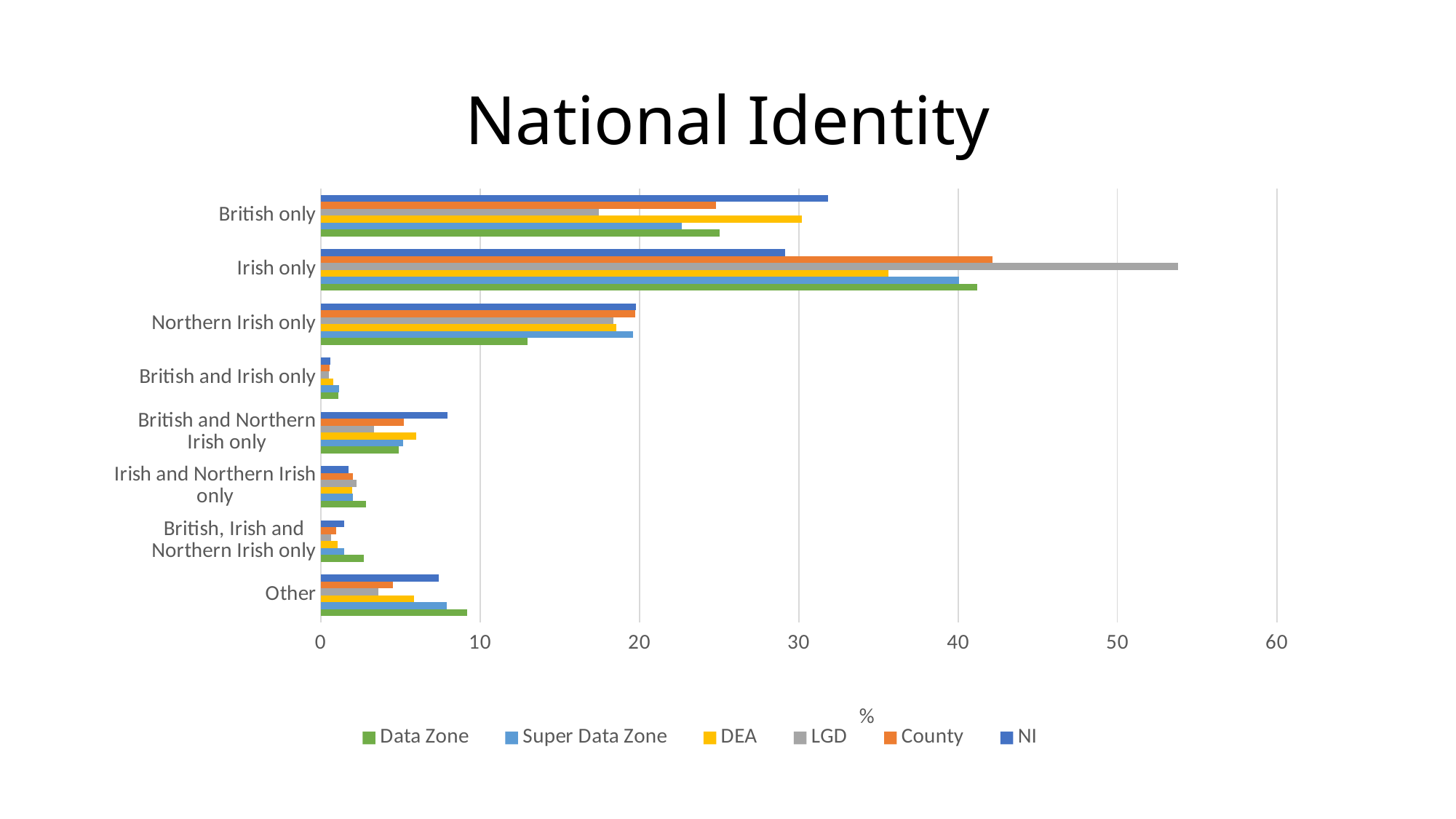
Is the Data Zone value for Irish only greater or less than 40? greater What kind of chart is shown on the slide? Bar chart For British only, which is larger, the DEA value or the LGD value? DEA Is the Data Zone value for Northern Irish only greater or less than 15? less Which category has the shortest NI bar? British and Irish only Which category has the longest LGD bar? Irish only How many series does the legend list? 6 How many national identity categories are plotted on the chart? 8 What is the title of the chart? National Identity For Irish only, which is larger, the LGD value or the NI value? LGD Is the LGD value for Irish only greater or less than 50? greater